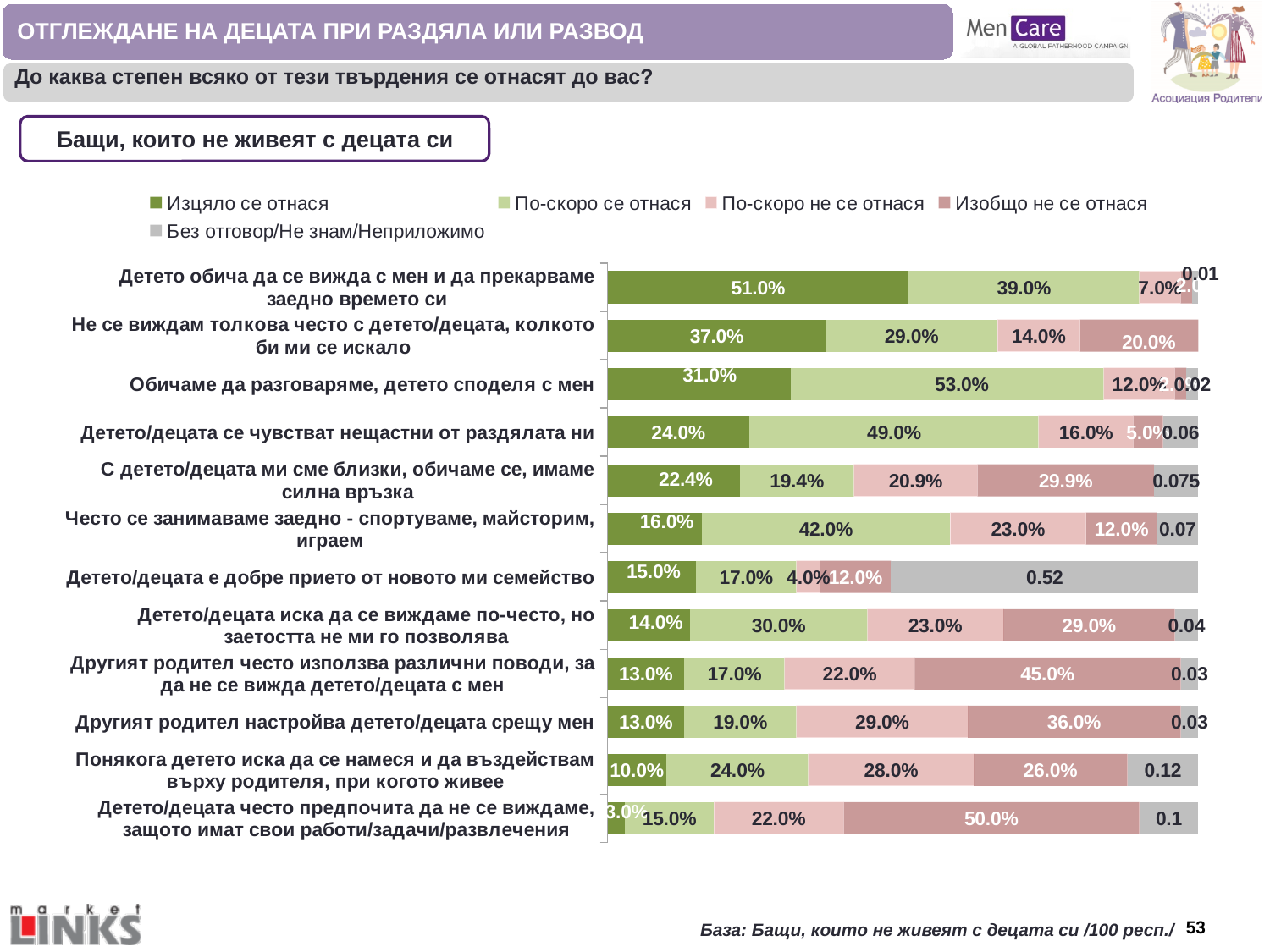
Which is larger: the "По-скоро не се отнася" value for "Другият родител настройва детето/децата срещу мен" or for "Често се занимаваме заедно - спортуваме, майсторим, играем"? Другият родител настройва детето/децата срещу мен What is the difference between the "Изобщо не се отнася" values for "Детето/децата често предпочита да не се виждаме, защото имат свои работи/задачи/развлечения" and "Другият родител настройва детето/децата срещу мен"? 14.0% What is the value of "По-скоро се отнася" for "Обичаме да разговаряме, детето споделя с мен"? 53.0% Which group of respondents does the chart describe, according to the box above the chart? Бащи, които не живеят с децата си What is the value of "Изцяло се отнася" for "Детето обича да се вижда с мен и да прекарваме заедно времето си"? 51.0% What is the value of "Без отговор/Не знам/Неприложимо" for "Детето/децата е добре прието от новото ми семейство"? 0.52 How many series does the legend list? 5 What kind of chart is shown on the slide? bar chart Which statement has the lowest value for "Изцяло се отнася"? Детето/децата често предпочита да не се виждаме, защото имат свои работи/задачи/развлечения Which statement has the highest value for "Изцяло се отнася"? Детето обича да се вижда с мен и да прекарваме заедно времето си What is the value of "Изобщо не се отнася" for "Другият родител често използва различни поводи, за да не се вижда детето/децата с мен"? 45.0% How many statements (categories) are plotted in the chart? 12